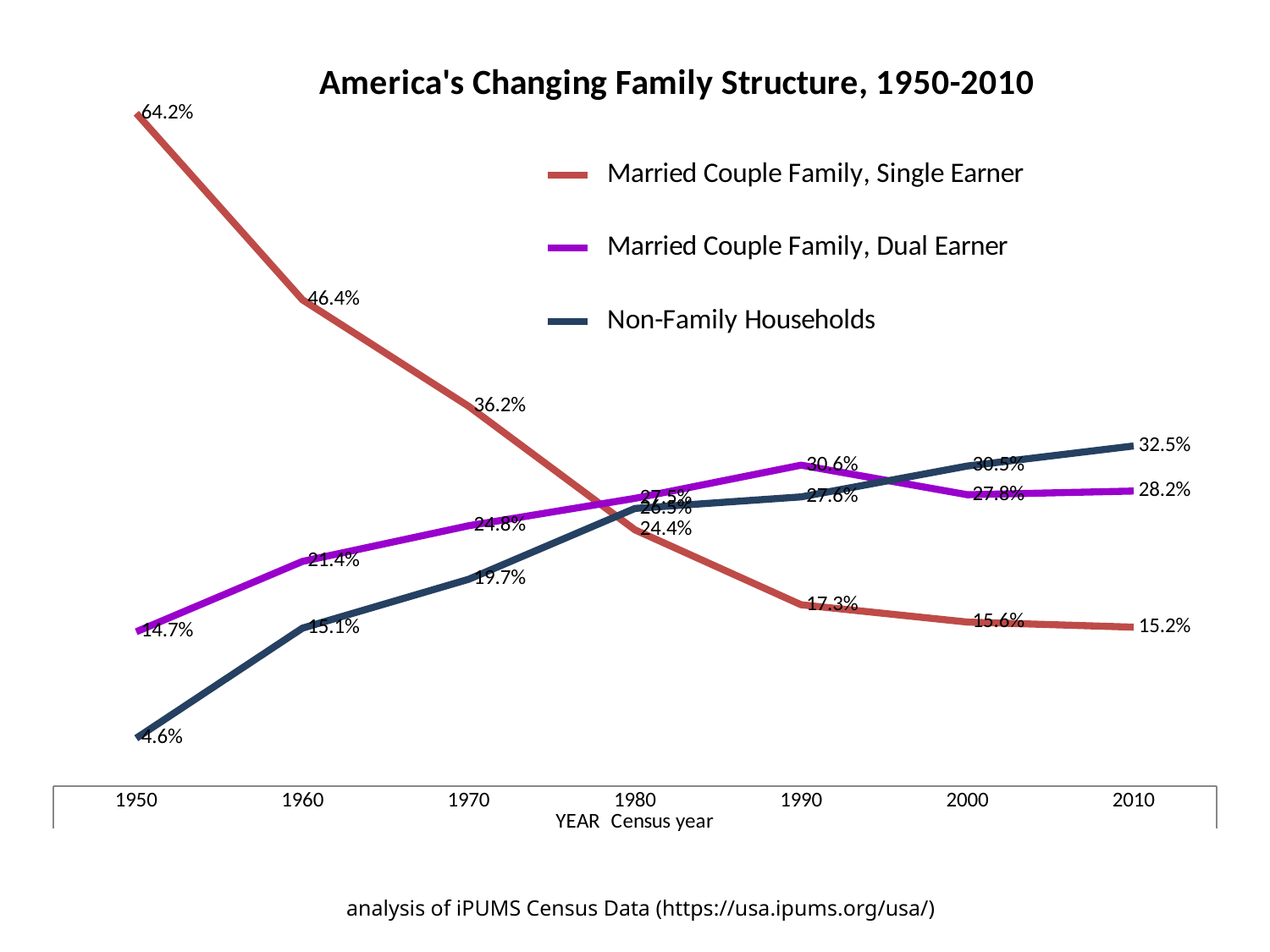
What is the value for Married Couple Family, Single Earner in 1950? 64.2% Does the Non-Family Households line rise or fall from 1950 to 2010? Rise Does the Married Couple Family, Single Earner line rise or fall from 1950 to 2010? Fall What is the value for Non-Family Households in 2010? 32.5% In which year is Non-Family Households at its lowest value? 1950 What is the value for Married Couple Family, Single Earner in 1990? 17.3% What is the difference between the Married Couple Family, Single Earner values in 1950 and 2010? 49.0 percentage points In 1990, which is larger: Married Couple Family, Dual Earner or Non-Family Households? Married Couple Family, Dual Earner How many census years are plotted along the x axis? 7 How many series does the legend list? 3 What is the value for Married Couple Family, Dual Earner in 1960? 21.4% What kind of chart is shown on the slide? Line chart